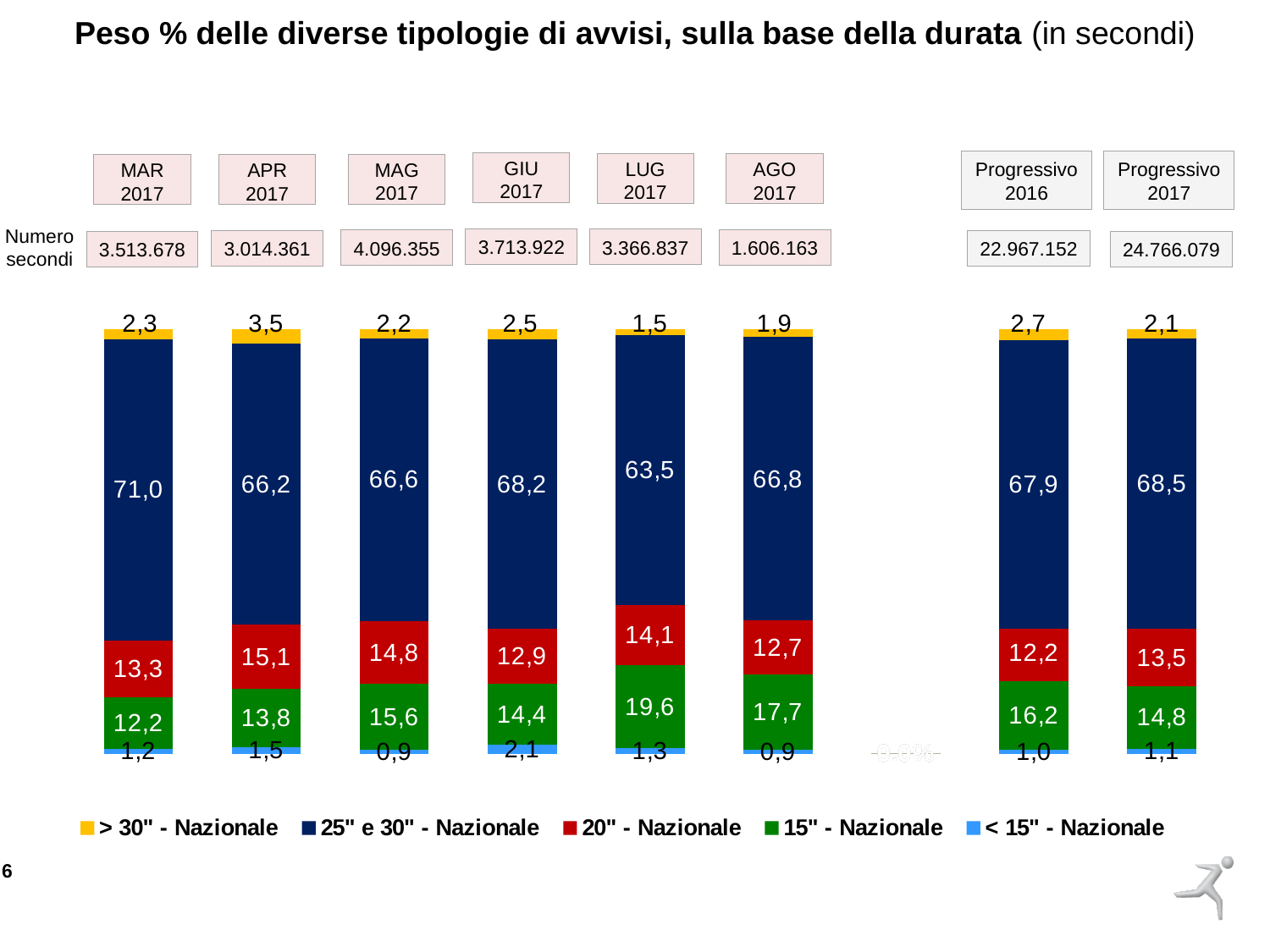
Which has a larger "15" - Nazionale" value, MAG 2017 or GIU 2017? MAG 2017 What is the value of the "25" e 30" - Nazionale" segment for MAR 2017? 71,0 Which bar has the lowest value for the "25" e 30" - Nazionale" segment? LUG 2017 How many series does the legend list? 5 What kind of chart is shown on the slide? Stacked bar chart What is the value of the "15" - Nazionale" segment for LUG 2017? 19,6 What is the value of the "> 30" - Nazionale" segment for APR 2017? 3,5 How many stacked bars are plotted in the chart? 8 What is the difference between the "20" - Nazionale" values for APR 2017 and MAR 2017? 1,8 What is the total of the stacked bar for MAR 2017? 100,0 Which bar has the highest value for the "25" e 30" - Nazionale" segment? MAR 2017 What colour represents the "20" - Nazionale" series in the legend? Red